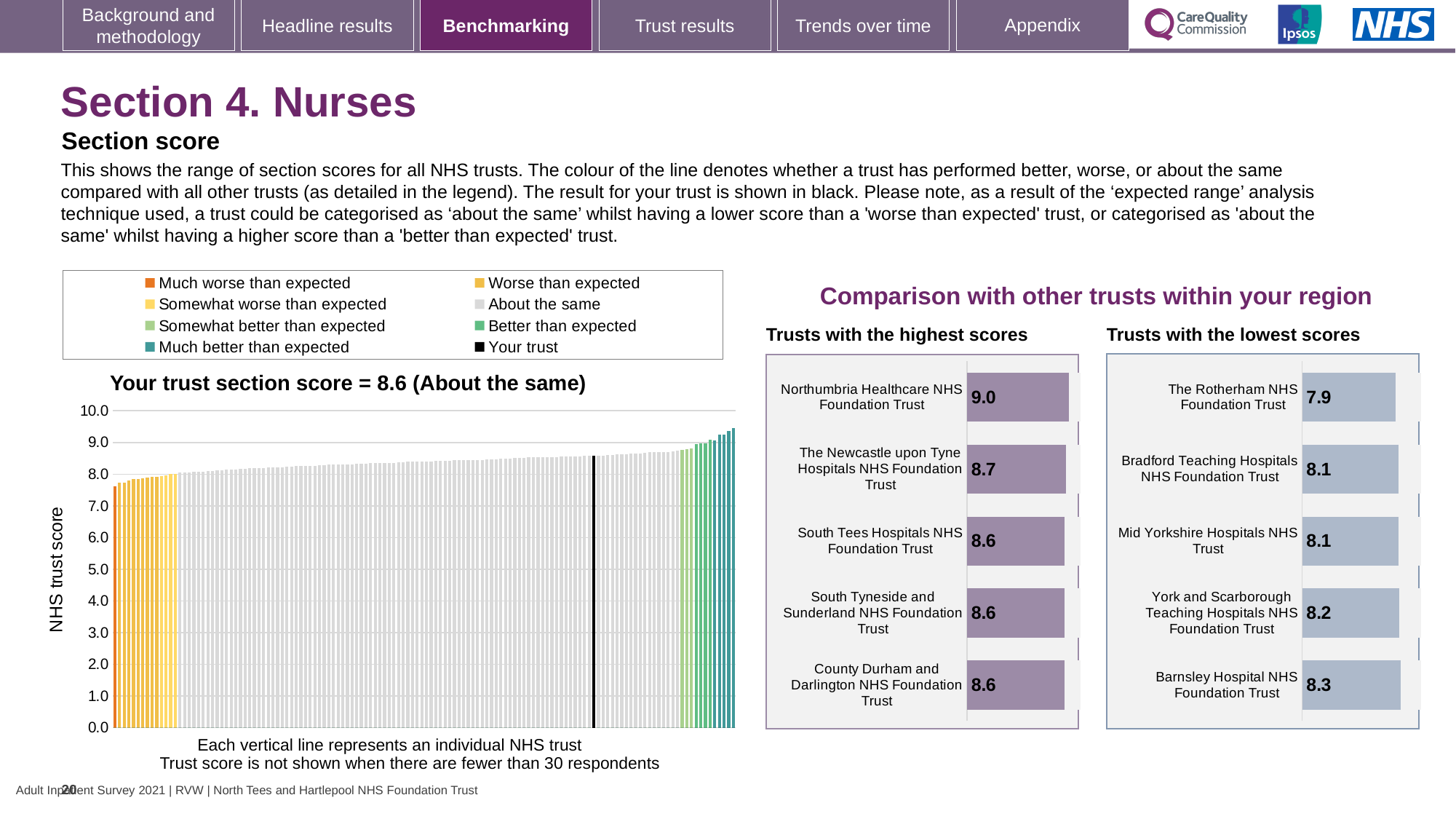
In the 'Trusts with the highest scores' chart, what is the score for The Newcastle upon Tyne Hospitals NHS Foundation Trust? 8.7 In the 'Trusts with the highest scores' chart, which trust has the highest score? Northumbria Healthcare NHS Foundation Trust How many entries does the legend of the main chart on the left list? 8 In the 'Trusts with the lowest scores' chart, what is the score for Barnsley Hospital NHS Foundation Trust? 8.3 In the 'Trusts with the lowest scores' chart, which trust has the lowest score? The Rotherham NHS Foundation Trust In the 'Trusts with the lowest scores' chart, what is the difference between the scores of Barnsley Hospital NHS Foundation Trust and The Rotherham NHS Foundation Trust? 0.4 In the 'Trusts with the lowest scores' chart, what is the score for The Rotherham NHS Foundation Trust? 7.9 In the 'Trusts with the highest scores' chart, what is the score for Northumbria Healthcare NHS Foundation Trust? 9.0 In the 'Trusts with the lowest scores' chart, which has the larger score: Bradford Teaching Hospitals NHS Foundation Trust or York and Scarborough Teaching Hospitals NHS Foundation Trust? York and Scarborough Teaching Hospitals NHS Foundation Trust According to the title of the main chart on the left, what is your trust's section score? 8.6 How many trusts are shown in the 'Trusts with the highest scores' chart? 5 In the 'Trusts with the highest scores' chart, what is the difference between the scores of Northumbria Healthcare NHS Foundation Trust and The Newcastle upon Tyne Hospitals NHS Foundation Trust? 0.3